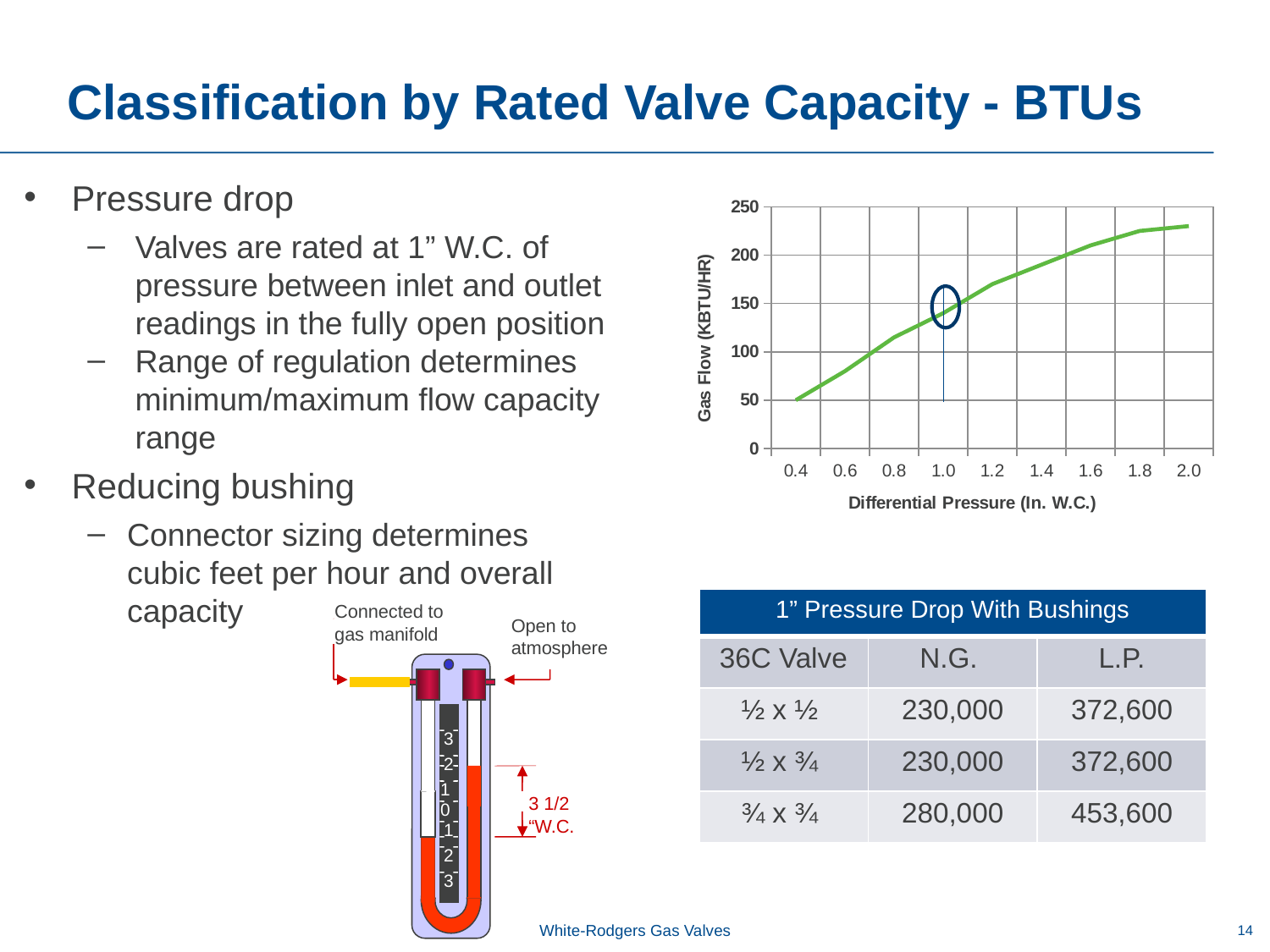
What is the title of the x axis of the chart? Differential Pressure (In. W.C.) Is the gas flow at a differential pressure of 0.6 greater or less than 100? less What kind of chart is shown on the slide? line chart What is the title of the y axis of the chart? Gas Flow (KBTU/HR) Does gas flow rise or fall as differential pressure increases along the x axis? rise Is the gas flow at a differential pressure of 0.8 greater or less than 150? less At which differential pressure on the x axis is the gas flow lowest? 0.4 Is the gas flow at a differential pressure of 2.0 greater or less than 200? greater At which differential pressure on the x axis is the gas flow highest? 2.0 Is the gas flow higher at a differential pressure of 1.6 or at 0.8? 1.6